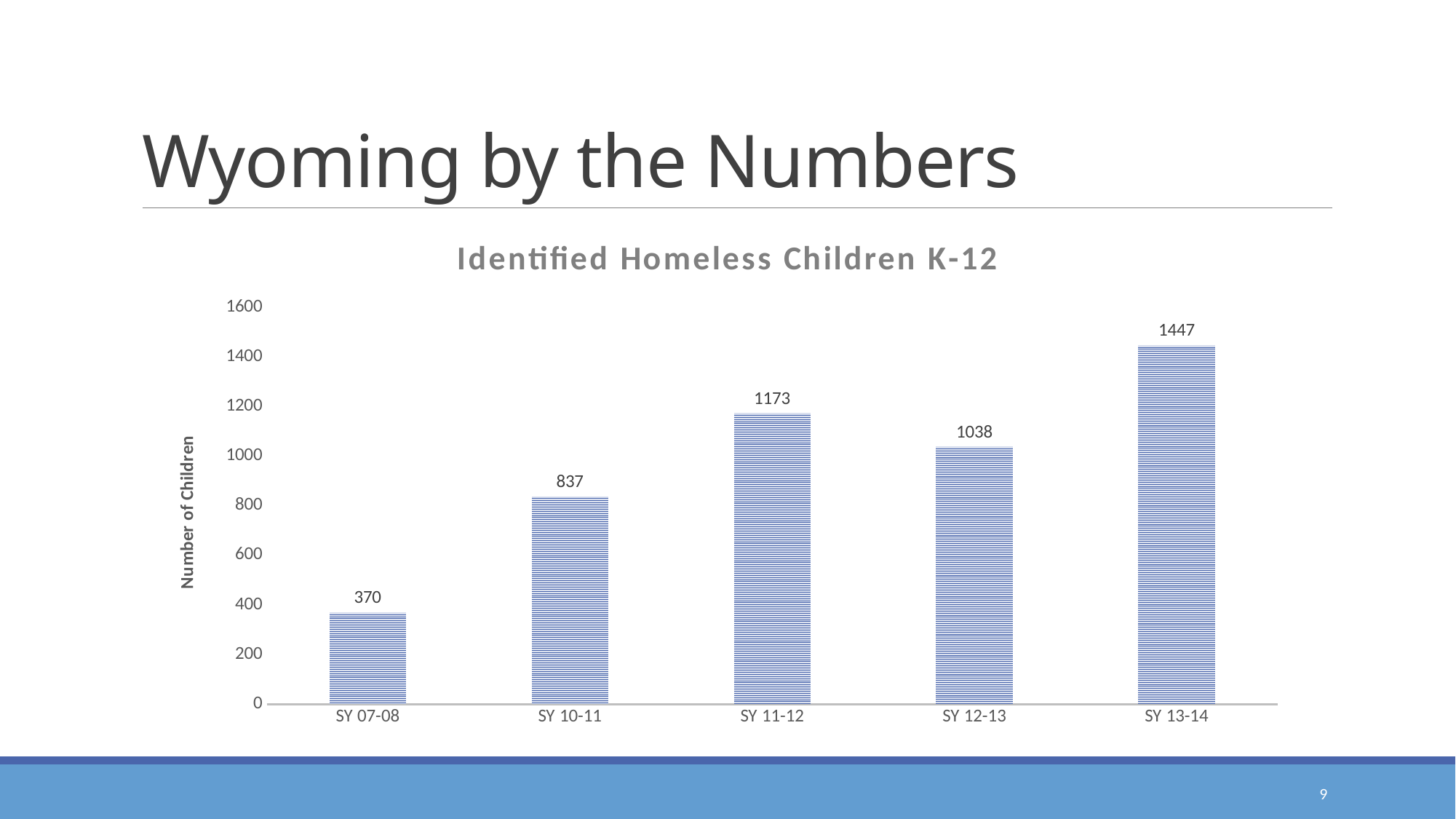
What is the title of the chart? Identified Homeless Children K-12 Which school year has the lowest number of identified homeless children? SY 07-08 What kind of chart is shown on the slide? bar chart Which school year has the highest number of identified homeless children? SY 13-14 What is the difference between the values for SY 10-11 and SY 07-08? 467 How many school years are shown on the x axis? 5 What is the value for SY 07-08? 370 What is the value for SY 13-14? 1447 What is the difference between the values for SY 13-14 and SY 12-13? 409 Which is larger, the value for SY 11-12 or the value for SY 12-13? SY 11-12 What is the value for SY 11-12? 1173 Is the value for SY 10-11 greater or less than 1000? less